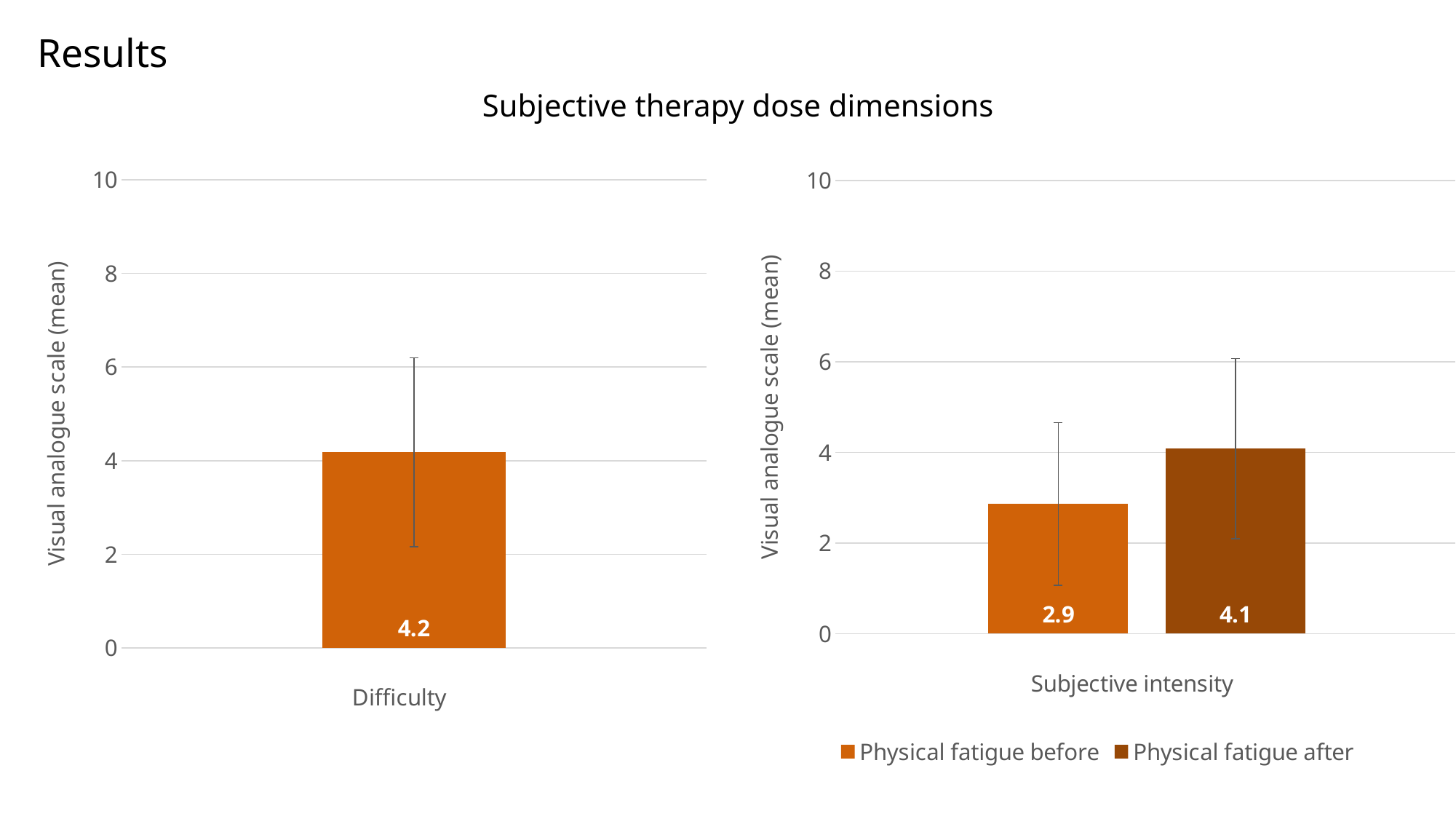
In the right chart (Subjective intensity), which series has the lower value? Physical fatigue before In the right chart (Subjective intensity), what is the value for Physical fatigue after? 4.1 In the right chart (Subjective intensity), which series has the higher value? Physical fatigue after How many series does the legend of the right chart (Subjective intensity) list? 2 What is the overall title shown above the two charts? Subjective therapy dose dimensions What kind of chart is the left chart (Difficulty)? Bar chart In the right chart (Subjective intensity), is the value for Physical fatigue before greater or less than 4? less In the left chart (Difficulty), what is the mean visual analogue scale value shown on the bar? 4.2 In the left chart (Difficulty), is the value for Difficulty greater or less than 4? greater In the right chart (Subjective intensity), what is the difference between Physical fatigue after and Physical fatigue before? 1.2 In the right chart (Subjective intensity), what is the value for Physical fatigue before? 2.9 What is the y-axis label of the right chart (Subjective intensity)? Visual analogue scale (mean)